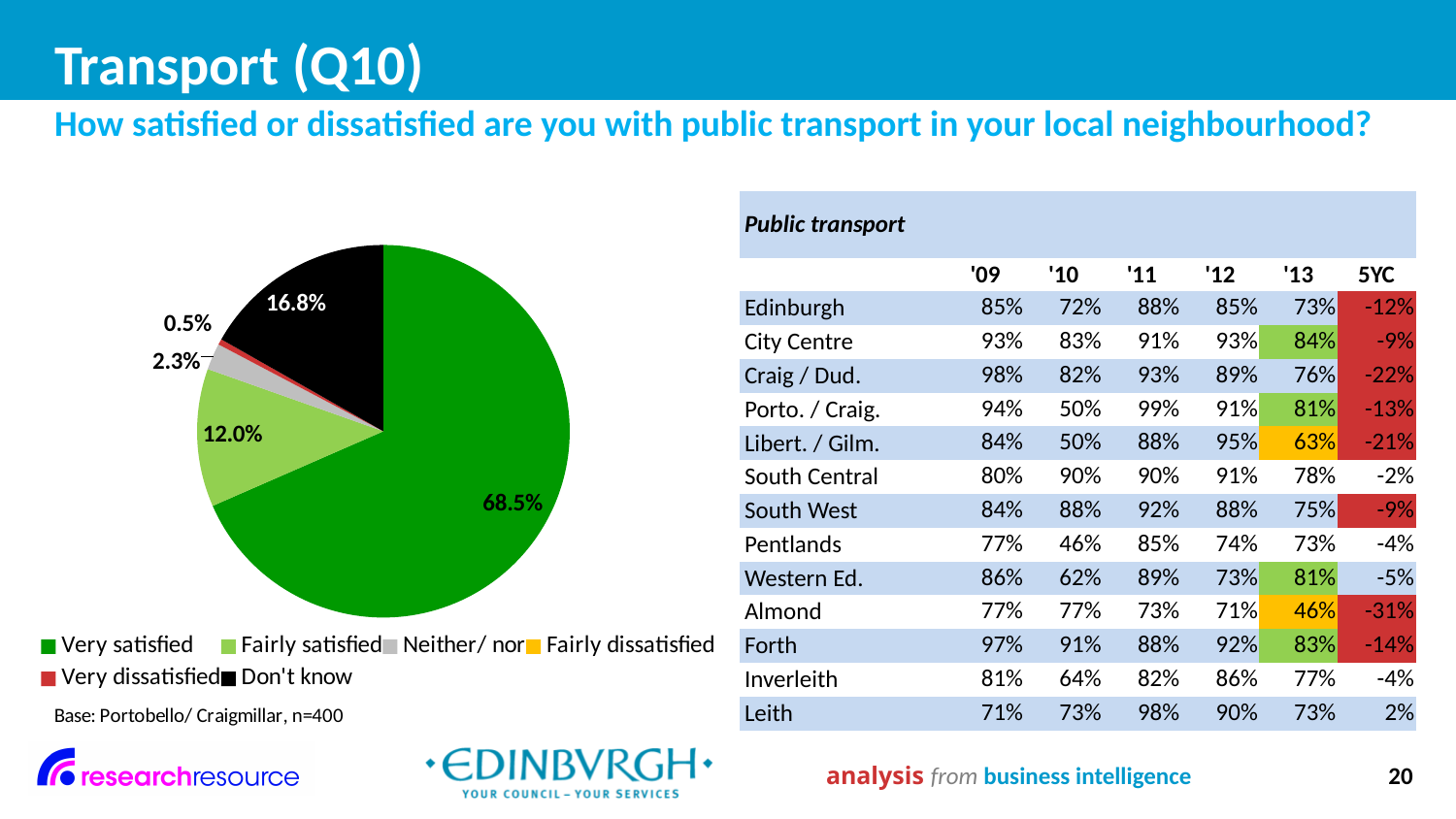
What percentage of respondents answered 'Neither/ nor'? 2.3% Which response category has the largest share of the pie? Very satisfied What colour is the 'Very satisfied' slice? dark green Which is larger, the 'Fairly satisfied' slice or the 'Don't know' slice? Don't know How many response categories does the legend list? 6 What percentage of respondents are fairly satisfied? 12.0% What is the combined share of 'Very satisfied' and 'Fairly satisfied' respondents? 80.5% What percentage of respondents are very satisfied with public transport? 68.5% What percentage of respondents answered 'Don't know'? 16.8% What kind of chart is shown on the slide? pie chart What is the difference between the 'Very satisfied' share and the 'Don't know' share? 51.7% What is the base (sample size) stated for the pie chart? Portobello/ Craigmillar, n=400